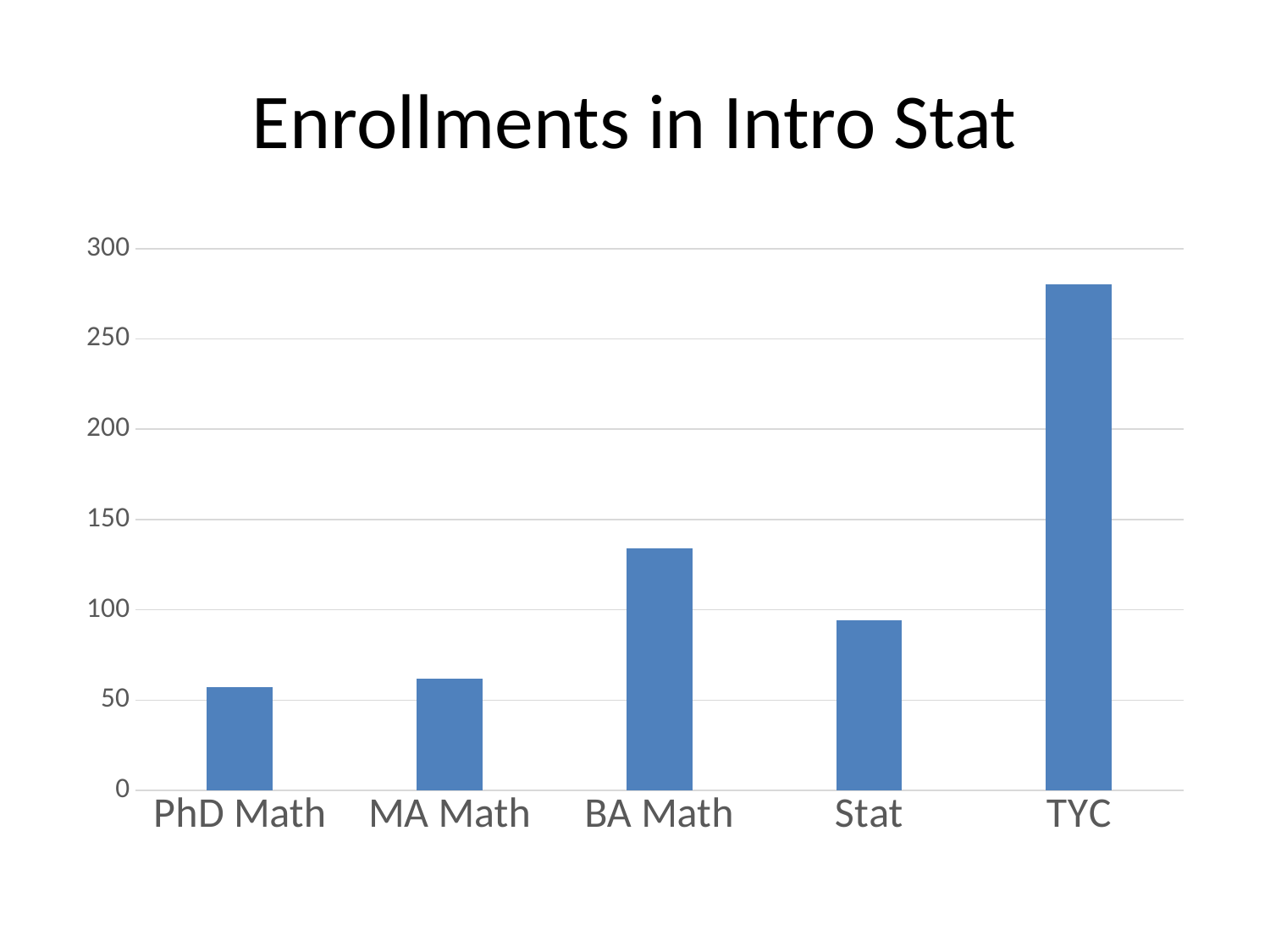
What is the title of the chart? Enrollments in Intro Stat Is the value for Stat greater or less than 100? less Which category has the lowest enrollment? PhD Math How many categories are shown on the x axis? 5 Is the value for BA Math greater or less than 150? less Which is larger, the value for BA Math or the value for Stat? BA Math Which category has the highest enrollment? TYC What type of chart is shown on the slide? bar chart What is the maximum value shown on the vertical axis? 300 Is the value for MA Math greater or less than 50? greater Which is larger, the value for TYC or the value for BA Math? TYC